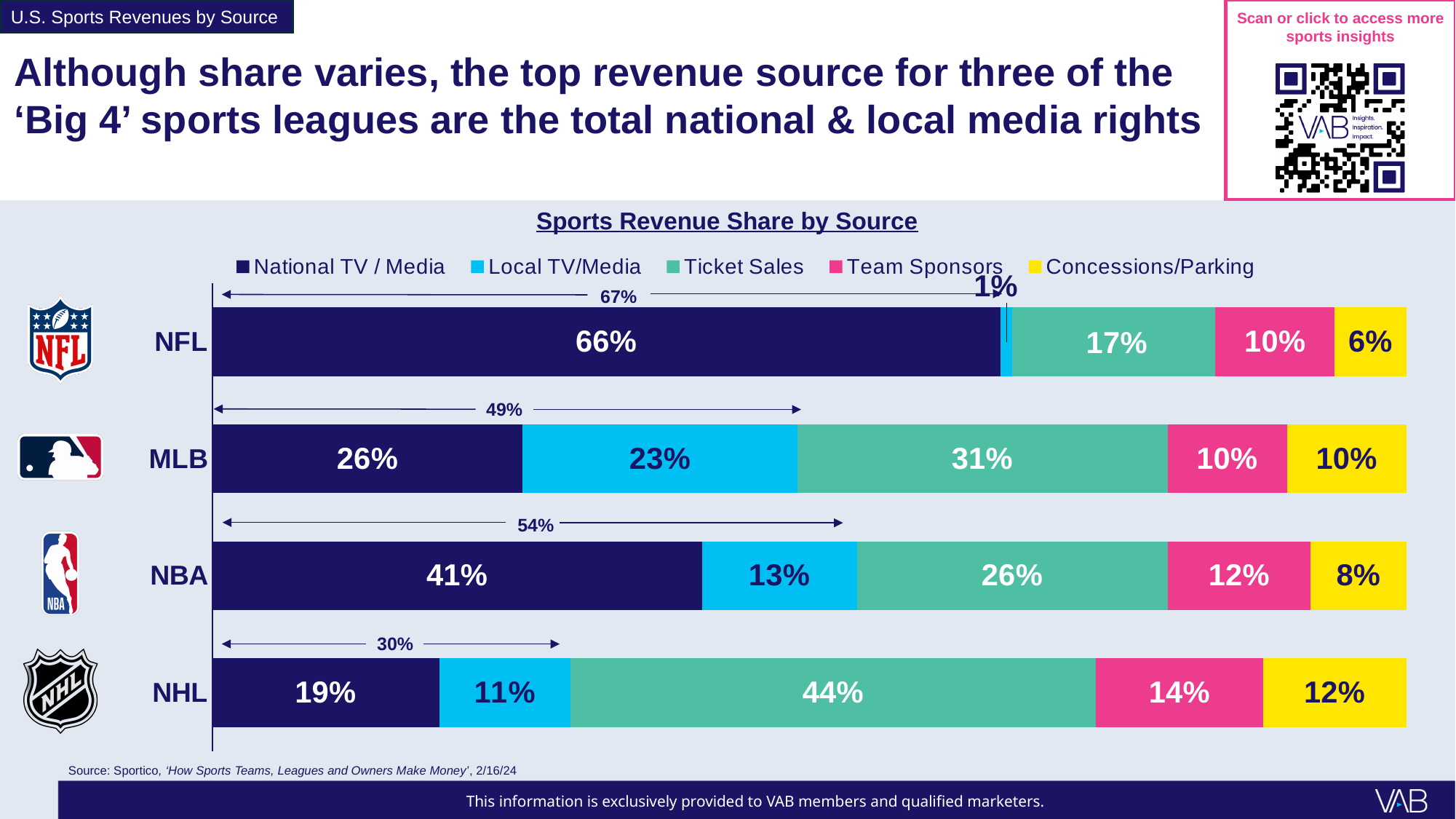
Which league has the lowest Ticket Sales share? NFL Which league has the highest National TV / Media share? NFL How many leagues are shown in the chart? 4 What is the National TV / Media share for the NFL? 66% What is the combined national and local media rights share shown for MLB? 49% How many series does the legend list? 5 What is the Concessions/Parking share for the NBA? 8% What is the Ticket Sales share for the NHL? 44% Which is larger: the Team Sponsors share for the NHL or for the NBA? NHL What is the difference between the NBA's National TV / Media share and its Local TV/Media share? 28% What is the Local TV/Media share for MLB? 23% What kind of chart is shown on the slide? Stacked bar chart